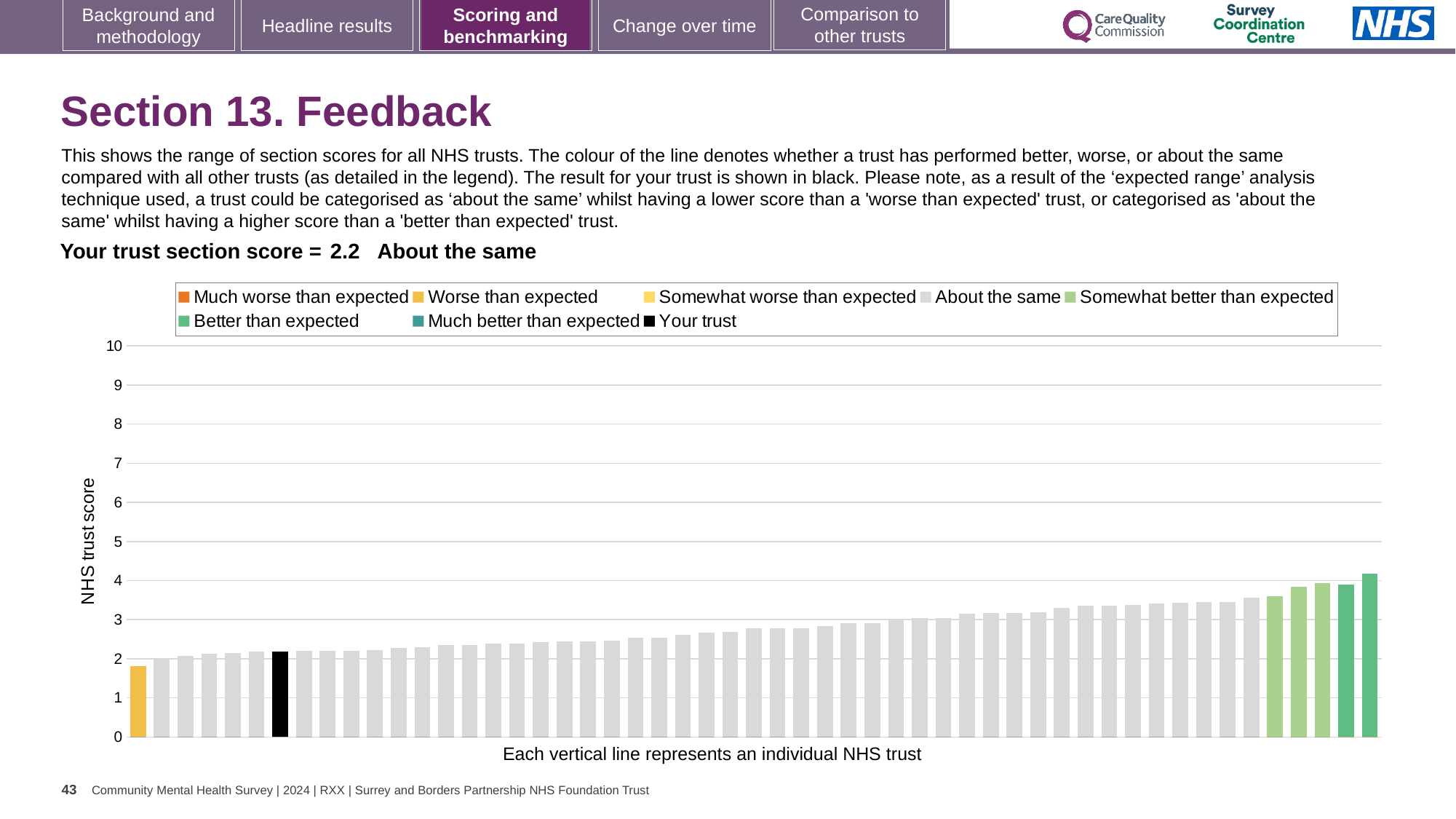
Is your trust's bar higher or lower than the tallest bar on the chart? Lower Is the value of the tallest bar greater or less than 5? less Which legend category does the tallest bar belong to? Better than expected What is the section score for your trust shown on the slide? 2.2 What is the label on the vertical axis of the chart? NHS trust score Is the value of the tallest bar greater or less than 3? greater Do the bar values rise or fall from left to right along the x axis? Rise What colour is used for the 'Your trust' bar in the chart? Black How many entries does the chart legend list? 8 What kind of chart is shown on the slide? Bar chart Which legend category does the shortest bar belong to? Worse than expected Is the value of the shortest bar greater or less than 3? less